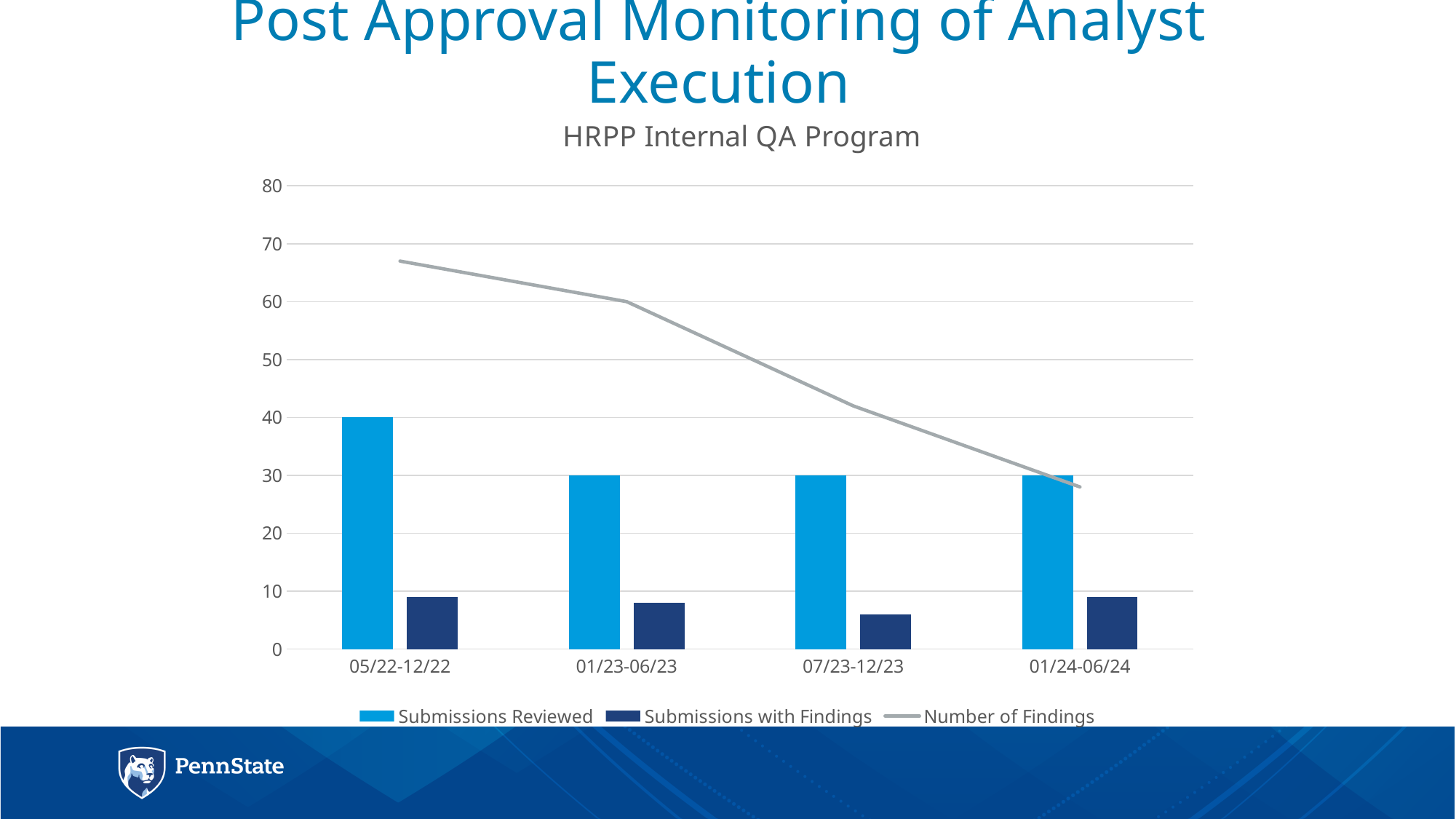
Is the Number of Findings for 05/22-12/22 greater or less than 60? greater What is the title of the chart? HRPP Internal QA Program Does the Number of Findings line rise or fall across the periods from 05/22-12/22 to 01/24-06/24? Fall What kind of chart is this? Combination bar and line chart What is the value of Submissions Reviewed for 01/23-06/23? 30 What is the value of Submissions Reviewed for 05/22-12/22? 40 Is the value for Submissions with Findings in 05/22-12/22 greater or less than 10? less How many time periods are shown on the x axis? 4 What is the Number of Findings for 01/23-06/23? 60 Which period has the highest value for Submissions Reviewed? 05/22-12/22 Which period has the lowest value for Submissions with Findings? 07/23-12/23 How many series does the legend list? 3